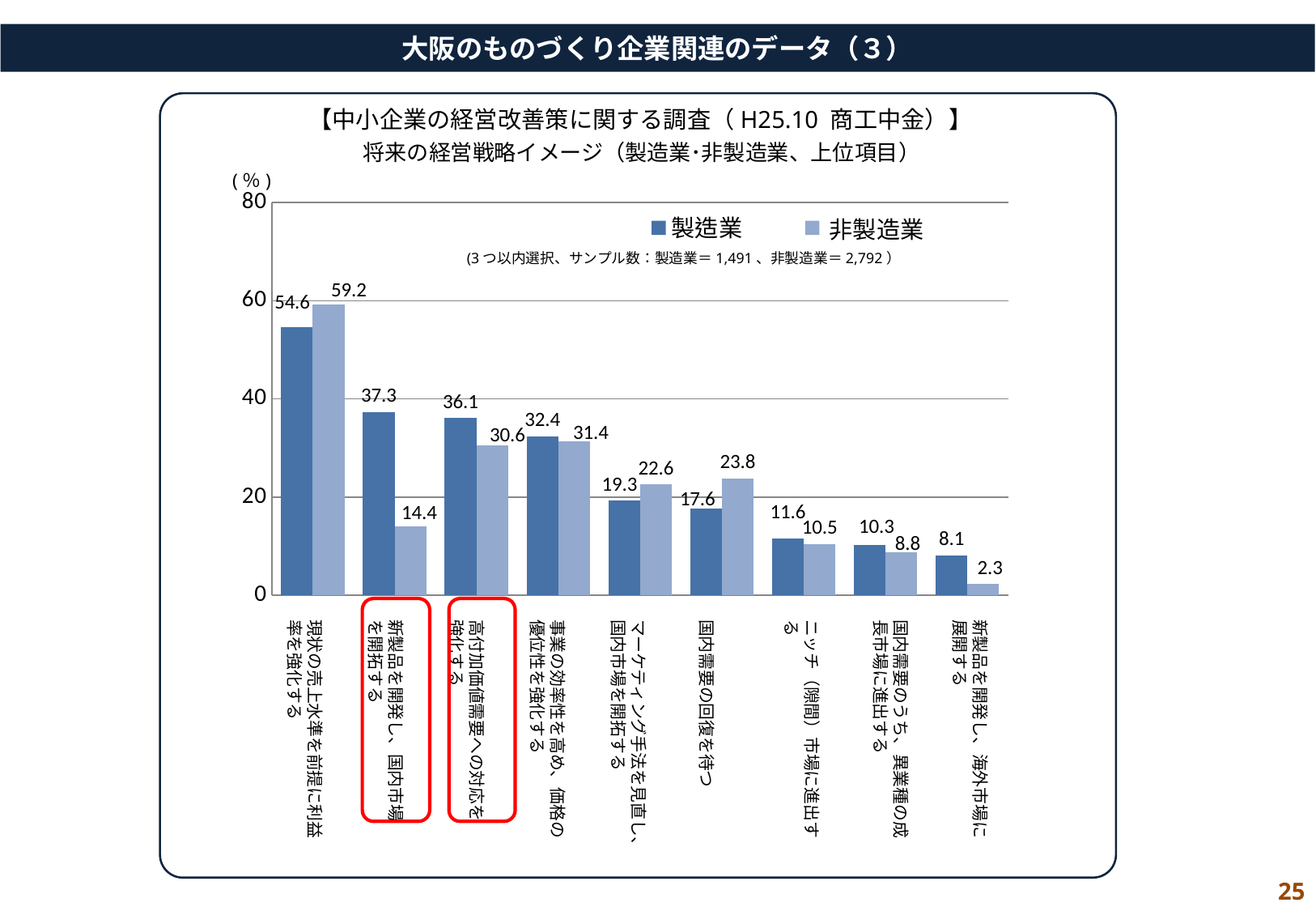
For 高付加価値需要への対応を強化する, which series has the larger value, 製造業 or 非製造業? 製造業 Which category has the lowest 非製造業 value? 新製品を開発し、海外市場に展開する How many categories are shown on the x axis? 9 What is the difference between the 製造業 and 非製造業 values for 新製品を開発し、国内市場を開拓する? 22.9 What is the 非製造業 value for 新製品を開発し、海外市場に展開する? 2.3 What kind of chart is shown on the slide? bar chart How many series does the legend list? 2 Which category has the highest 製造業 value? 現状の売上水準を前提に利益率を強化する What is the sample size for 製造業 stated on the chart? 1,491 Is the 製造業 value for 現状の売上水準を前提に利益率を強化する greater or less than 40? greater What is the 非製造業 value for 国内需要の回復を待つ? 23.8 What is the 製造業 value for 新製品を開発し、国内市場を開拓する? 37.3